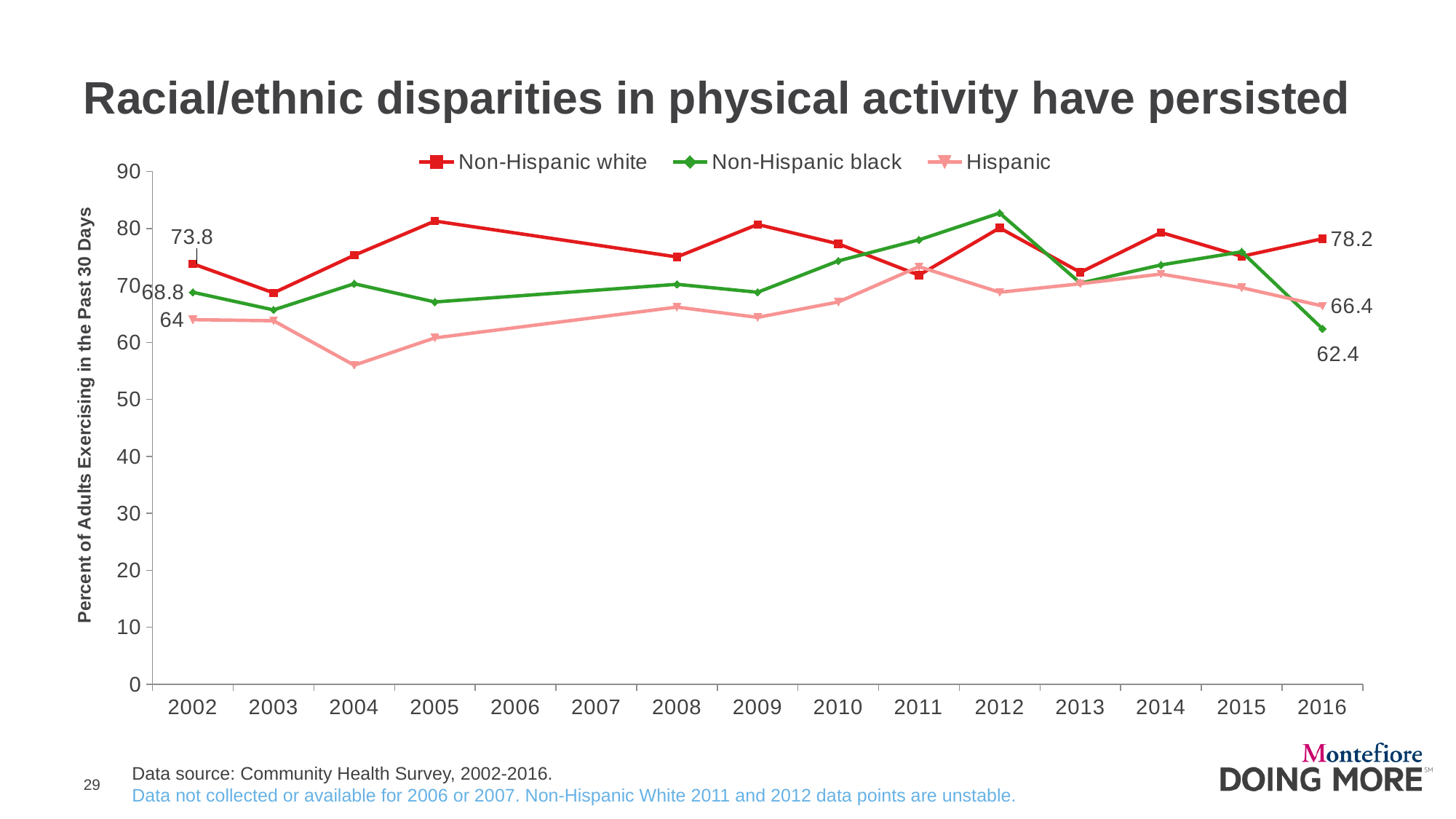
What kind of chart is shown on the slide? line chart What is the value for Non-Hispanic white in 2002? 73.8 What is the label on the vertical axis? Percent of Adults Exercising in the Past 30 Days What is the difference between the Non-Hispanic white and Non-Hispanic black values in 2016? 15.8 Is the value for Non-Hispanic black in 2012 greater or less than 80? greater Which series has the highest value in 2016? Non-Hispanic white What is the difference between the Non-Hispanic white and Hispanic values in 2002? 9.8 How many series does the legend list? 3 What is the value for Hispanic in 2016? 66.4 Is the value for Hispanic in 2004 greater or less than 60? less What is the value for Non-Hispanic black in 2002? 68.8 What is the value for Non-Hispanic black in 2016? 62.4